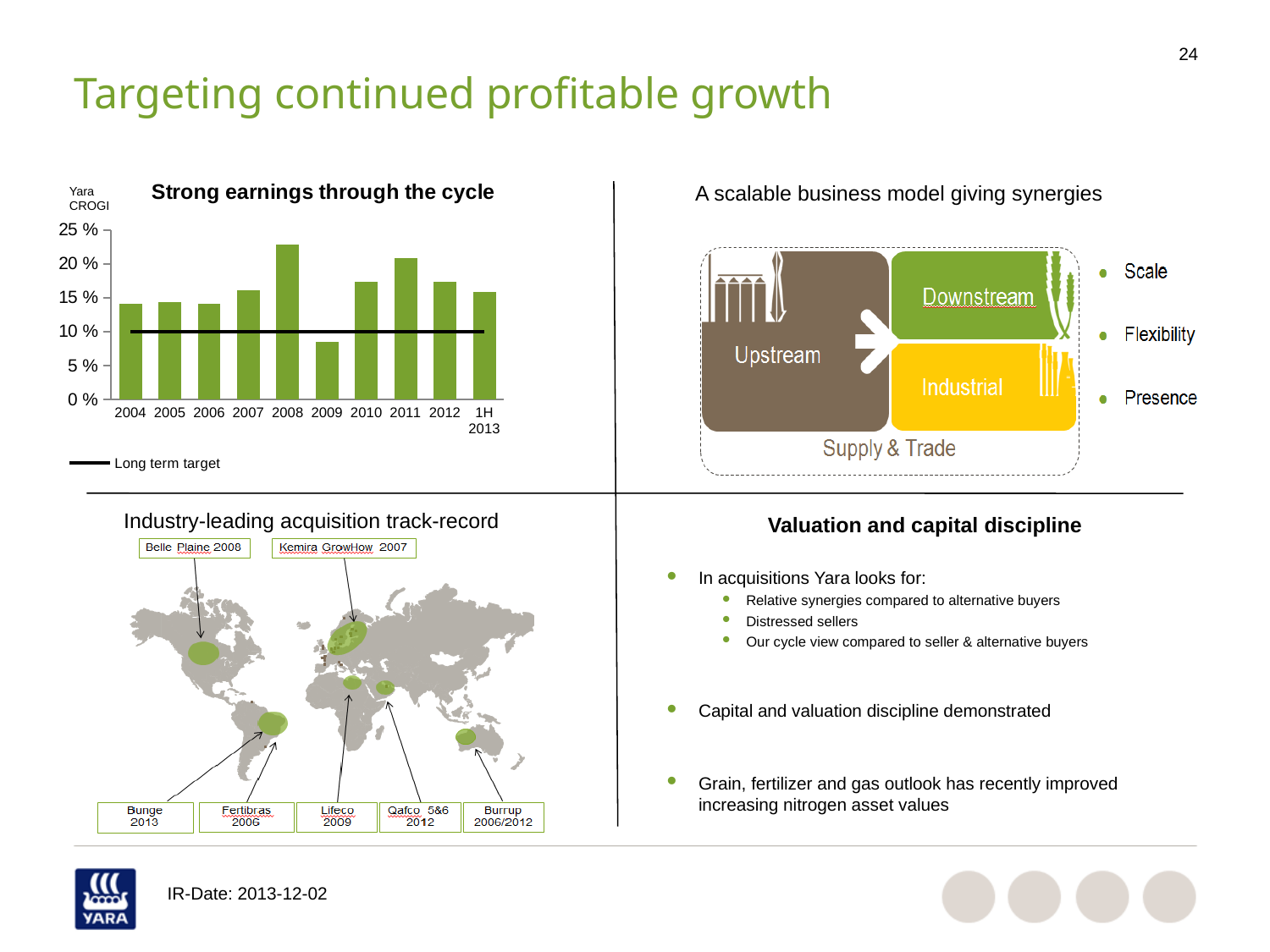
How many periods are shown on the x axis of the 'Strong earnings through the cycle' chart? 10 What kind of chart is 'Strong earnings through the cycle'? bar chart In the 'Strong earnings through the cycle' chart, is the value for 2008 greater or less than 20 %? greater In the 'Strong earnings through the cycle' chart, which is larger, the value for 2011 or the value for 2007? 2011 In the 'Strong earnings through the cycle' chart, is the value for 2011 greater or less than 20 %? greater In the 'Strong earnings through the cycle' chart, which is larger, the value for 2008 or the value for 2009? 2008 In the 'Strong earnings through the cycle' chart, at what level is the long term target line drawn? 10 % In the 'Strong earnings through the cycle' chart, which year has the lowest CROGI? 2009 In the 'Strong earnings through the cycle' chart, which year has the highest CROGI? 2008 In the 'Strong earnings through the cycle' chart, is the value for 2004 greater or less than 15 %? less What does the black horizontal line in the 'Strong earnings through the cycle' chart represent, according to the legend? Long term target